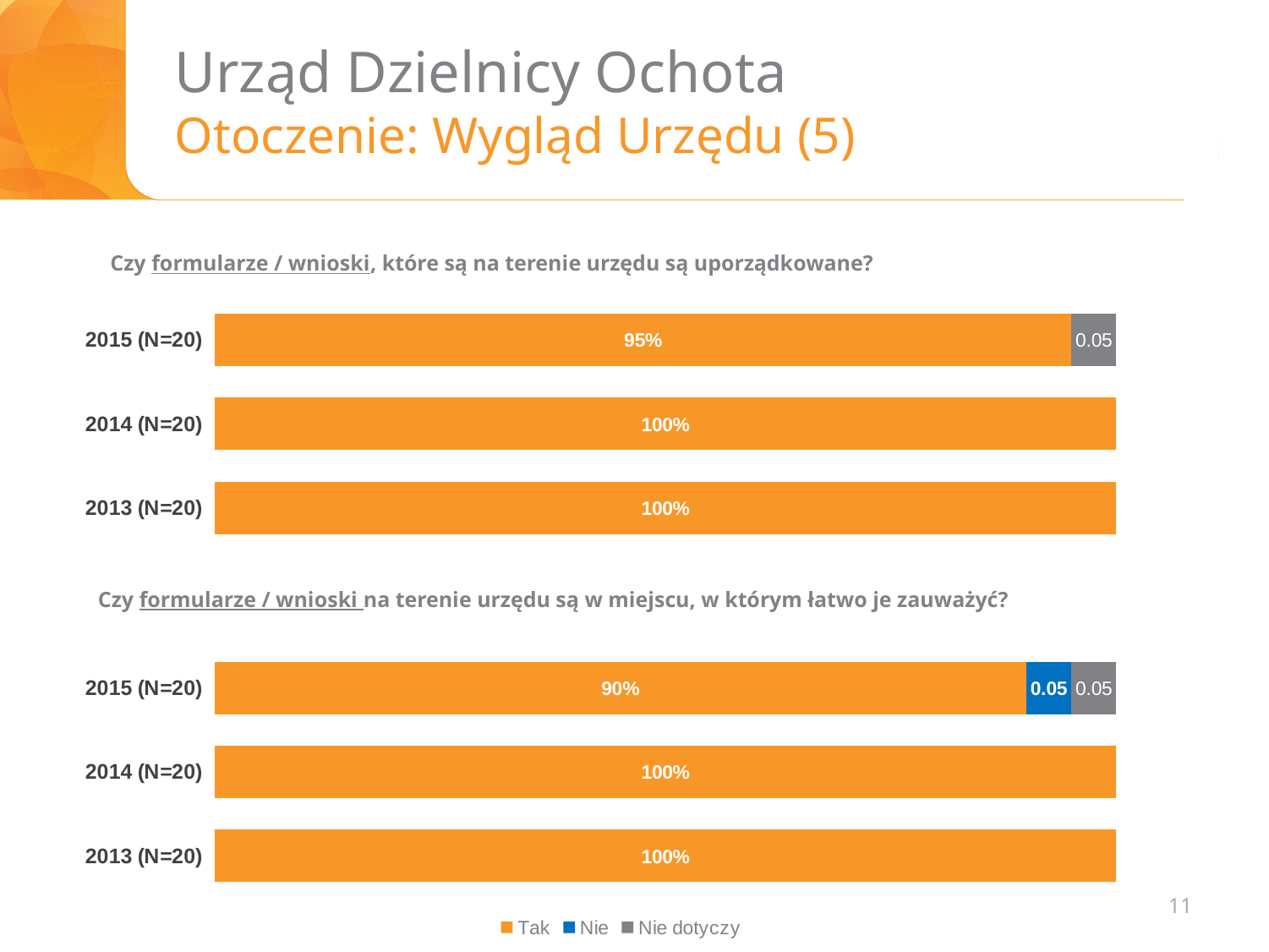
In the bottom chart ("Czy formularze / wnioski na terenie urzędu są w miejscu, w którym łatwo je zauważyć?"), what is the Tak value for 2015 (N=20)? 90% In the bottom chart ("Czy formularze / wnioski na terenie urzędu są w miejscu, w którym łatwo je zauważyć?"), is the Tak value for 2015 (N=20) larger or smaller than the Tak value for 2014 (N=20)? smaller In the top chart ("Czy formularze / wnioski, które są na terenie urzędu są uporządkowane?"), what is the Tak value for 2014 (N=20)? 100% In the top chart ("Czy formularze / wnioski, które są na terenie urzędu są uporządkowane?"), what value is shown for Nie dotyczy in 2015 (N=20)? 0.05 In the bottom chart ("Czy formularze / wnioski na terenie urzędu są w miejscu, w którym łatwo je zauważyć?"), which year has the lowest Tak value? 2015 (N=20) In the bottom chart ("Czy formularze / wnioski na terenie urzędu są w miejscu, w którym łatwo je zauważyć?"), what is the Tak value for 2013 (N=20)? 100% In the top chart ("Czy formularze / wnioski, które są na terenie urzędu są uporządkowane?"), which year has the lowest Tak value? 2015 (N=20) In the bottom chart ("Czy formularze / wnioski na terenie urzędu są w miejscu, w którym łatwo je zauważyć?"), what value is shown for Nie in 2015 (N=20)? 0.05 In the top chart ("Czy formularze / wnioski, które są na terenie urzędu są uporządkowane?"), what is the Tak value for 2015 (N=20)? 95% How many series does the legend at the bottom of the slide list? 3 In the top chart ("Czy formularze / wnioski, które są na terenie urzędu są uporządkowane?"), what is the difference between the Tak value for 2014 (N=20) and the Tak value for 2015 (N=20)? 5% How many categories (years) does the top chart ("Czy formularze / wnioski, które są na terenie urzędu są uporządkowane?") show? 3